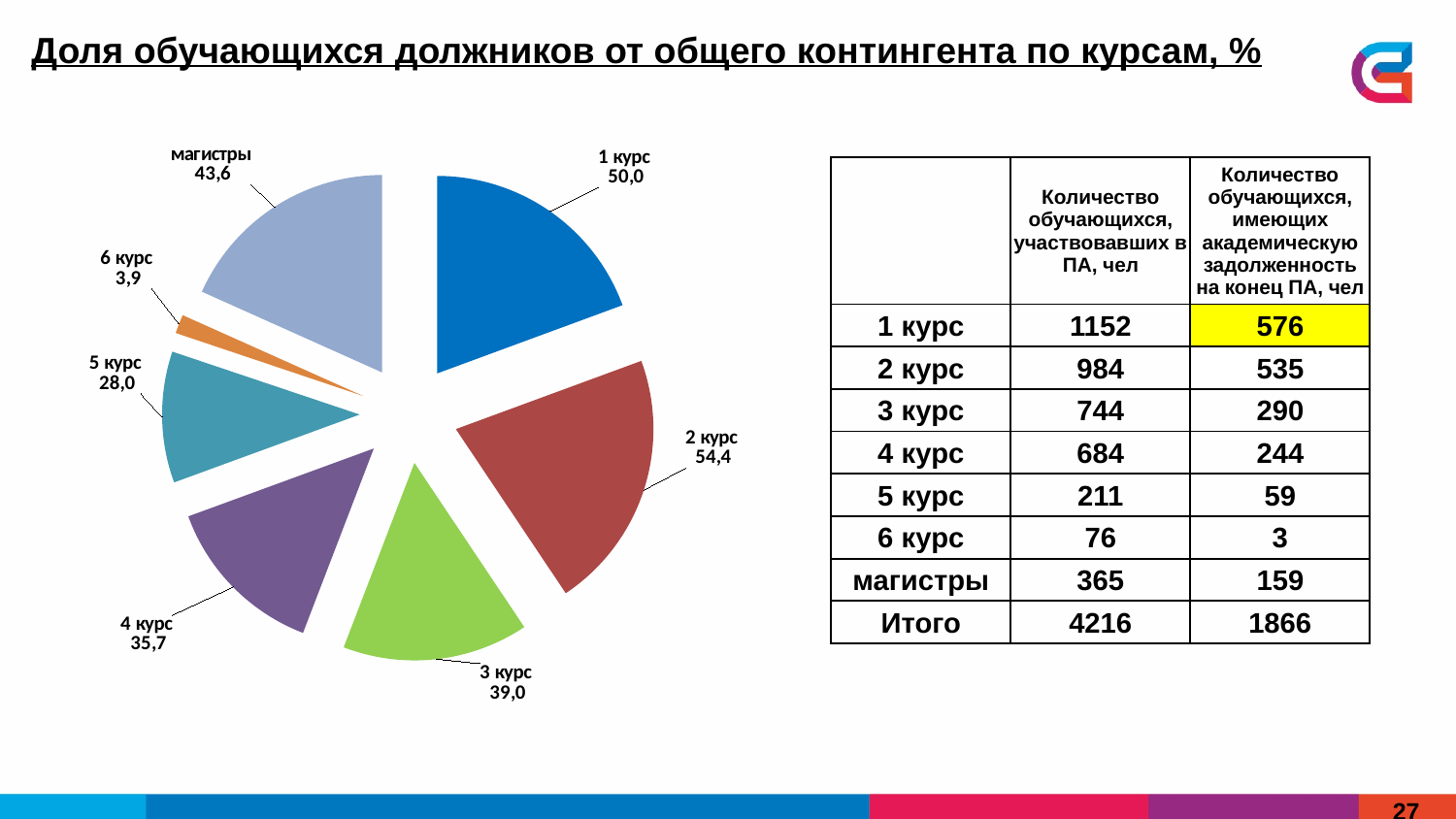
What is the value shown for 2 курс in the pie chart? 54,4 What is the value shown for 6 курс in the pie chart? 3,9 Which category has the largest slice in the pie chart? 2 курс What is the value shown for магистры in the pie chart? 43,6 Which category has the smallest slice in the pie chart? 6 курс Which has a larger value in the pie chart, 3 курс or 5 курс? 3 курс What is the value shown for 1 курс in the pie chart? 50,0 How many slices does the pie chart have? 7 What is the title of the slide's chart? Доля обучающихся должников от общего контингента по курсам, % What is the difference between the values for 2 курс and 1 курс in the pie chart? 4,4 What kind of chart is shown on the slide? pie chart What is the value shown for 4 курс in the pie chart? 35,7